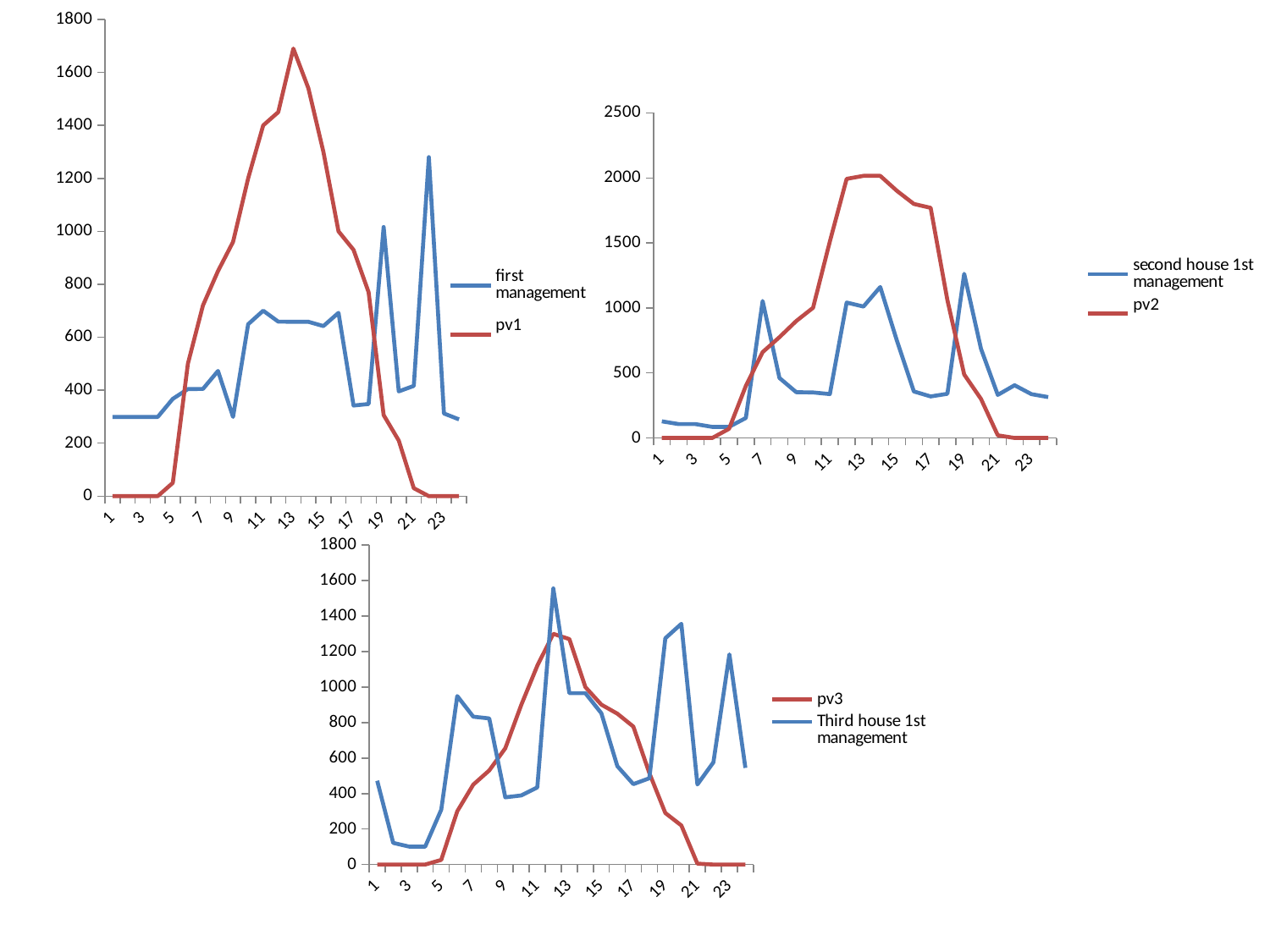
What are the legend entries of the top-right chart? second house 1st management, pv2 In the top-left chart, at x = 13, which series is higher, pv1 or first management? pv1 In the top-right chart, at x = 7, which series is higher, pv2 or second house 1st management? second house 1st management What is the highest value shown on the y axis of the top-right chart? 2500 In the top-left chart, does pv1 rise or fall from x = 13 to x = 24? fall In the bottom chart, is the value of Third house 1st management at x = 12 greater or less than 1400? greater In the bottom chart, is the value of pv3 at x = 22 greater or less than 200? less How many series does the legend of the top-left chart list? 2 In the top-right chart, is the value of pv2 at x = 13 greater or less than 1500? greater In the top-left chart, at which x-axis value does pv1 reach its highest point? 13 What kind of chart is the top-left chart? line chart